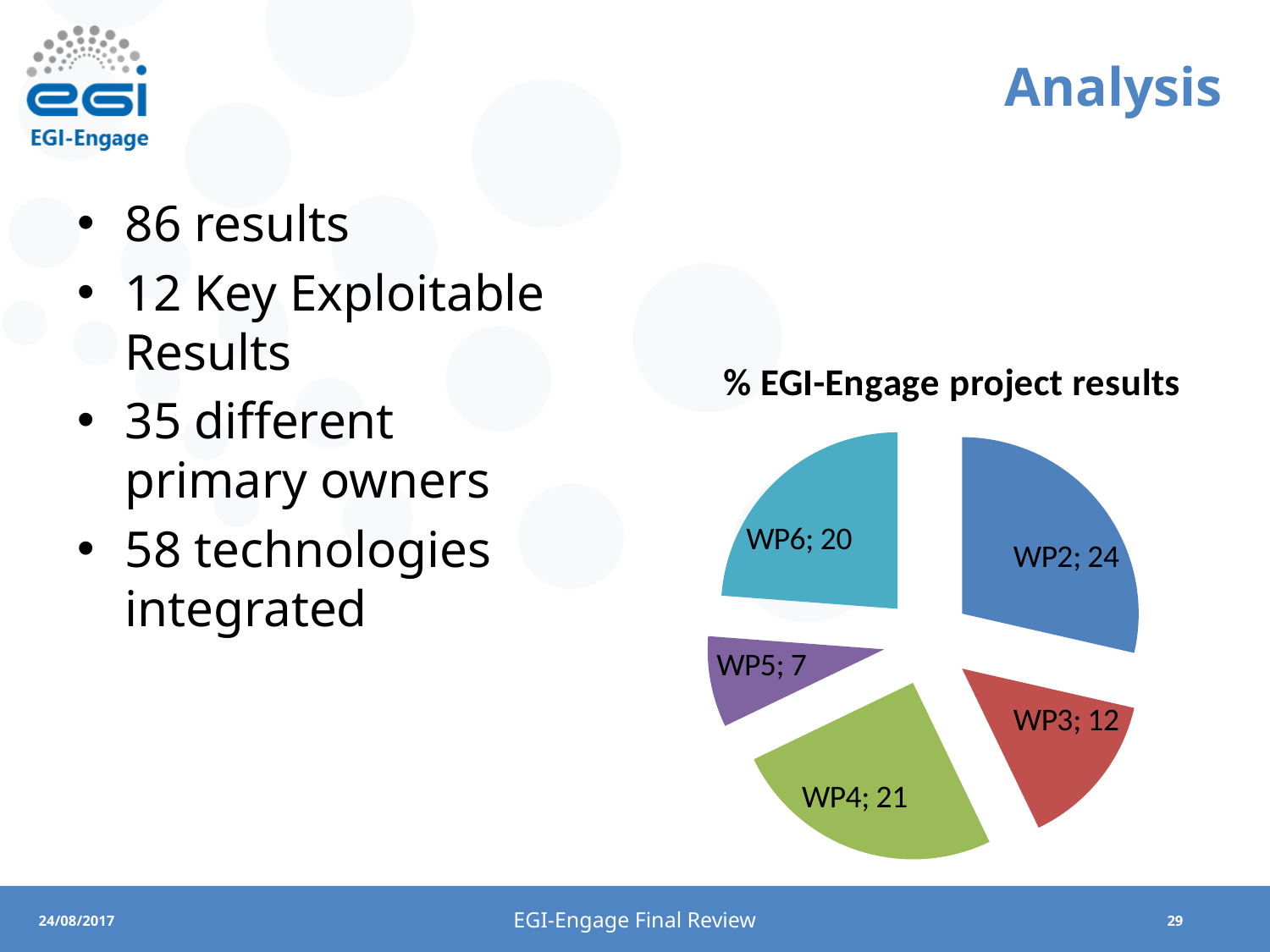
What is the title of the chart? % EGI-Engage project results How many slices does the pie chart have? 5 What is the value shown for WP6? 20 What is the value shown for WP4? 21 Which is larger, the value for WP4 or the value for WP6? WP4 What is the value shown for WP5? 7 What is the difference between the values for WP2 and WP3? 12 What type of chart is shown on the slide? pie chart What is the value shown for WP2? 24 Which work package has the smallest slice? WP5 Which work package has the largest slice? WP2 What is the value shown for WP3? 12